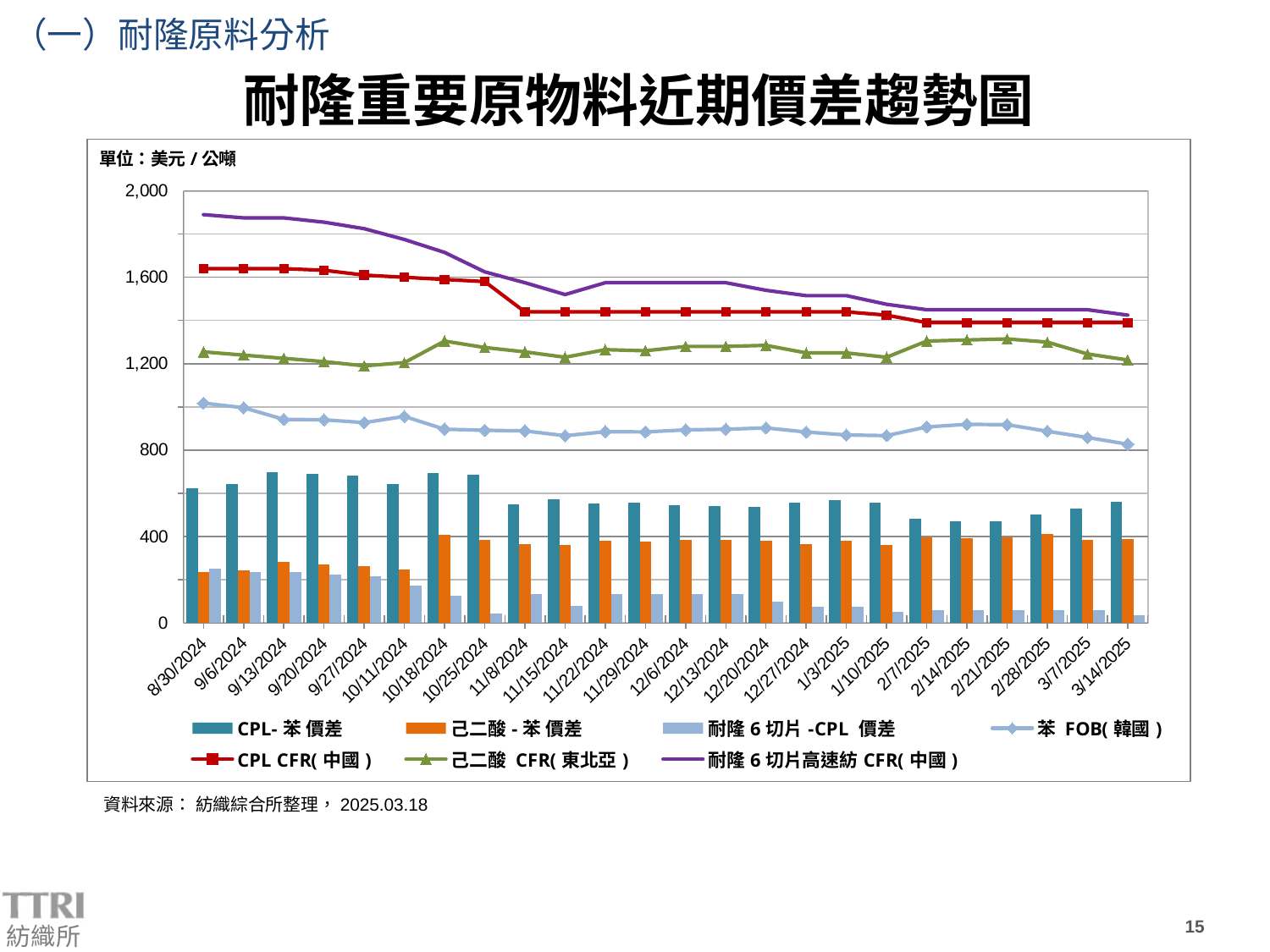
What kind of chart is shown on the slide? A combined bar and line chart Is the value for 耐隆6切片-CPL 價差 on 3/14/2025 greater or less than 400? less Is the value for CPL-苯 價差 on 9/13/2024 greater or less than 400? greater How many dates are shown along the x axis? 24 Is the value for CPL CFR(中國) on 3/14/2025 greater or less than 1,600? less On 8/30/2024, which is larger: CPL-苯 價差 or 己二酸-苯 價差? CPL-苯 價差 Which series has the highest value on 8/30/2024? 耐隆6切片高速紡 CFR(中國) What unit is stated for the values in the chart? 美元/公噸 How many series does the legend list? 7 Does the 耐隆6切片高速紡 CFR(中國) line generally rise or fall from 8/30/2024 to 3/14/2025? fall